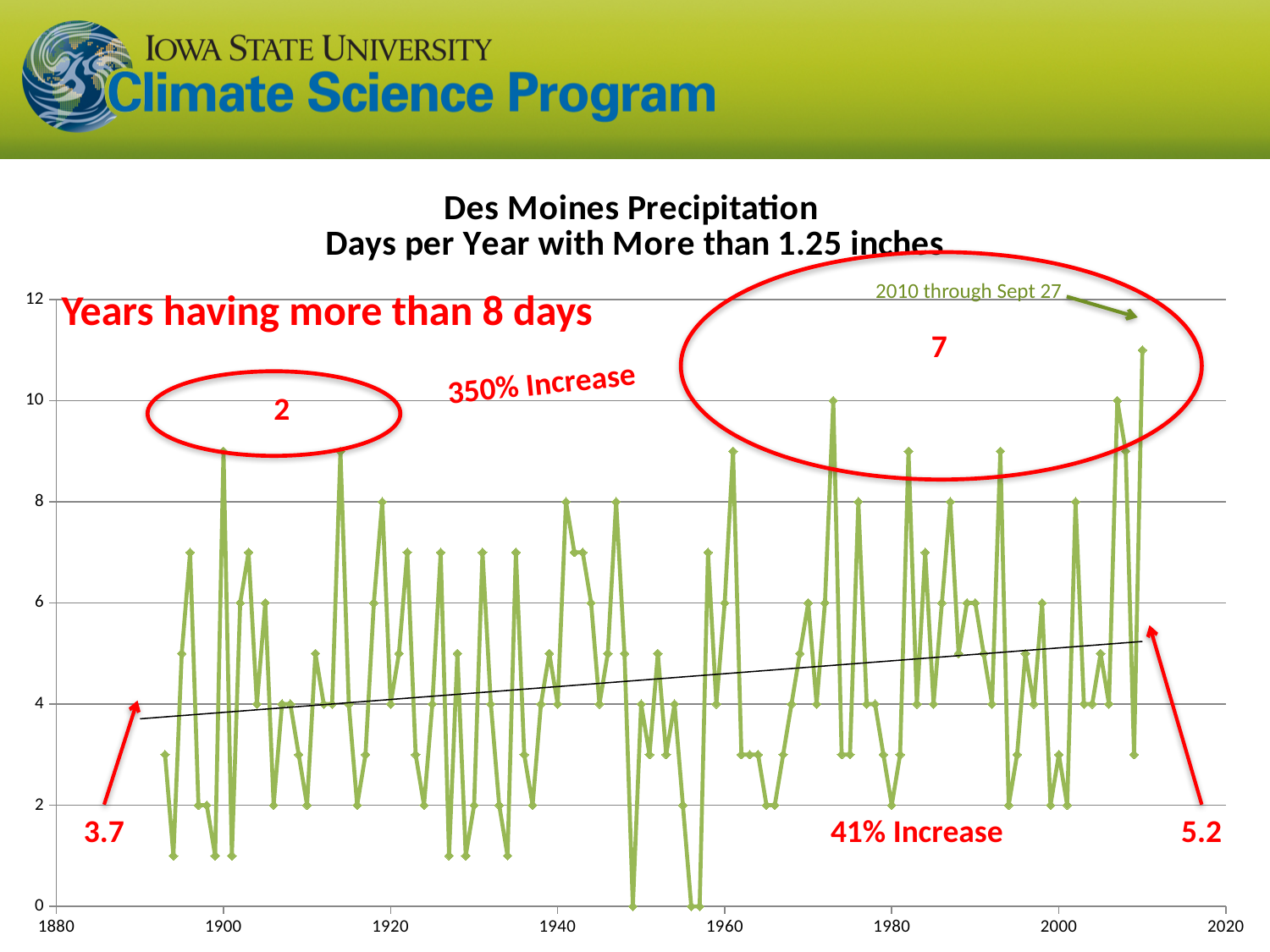
According to the trend line, do the number of days per year with more than 1.25 inches rise or fall from 1880 to 2020? rise How many years having more than 8 days are counted in the early circled period? 2 What value does the trend line reach at the right side of the chart? 5.2 How many years having more than 8 days are counted in the later circled period? 7 What kind of chart is shown on the slide? line chart Is the value for 2010 greater or less than 10? greater What is the title of the chart? Des Moines Precipitation Days per Year with More than 1.25 inches What is the lowest value plotted on the chart? 0 What percentage increase is labelled for the number of years having more than 8 days? 350% Increase What value does the trend line start at on the left side of the chart? 3.7 What percentage increase is labelled for the trend line? 41% Increase Which year does the annotation 'through Sept 27' refer to? 2010